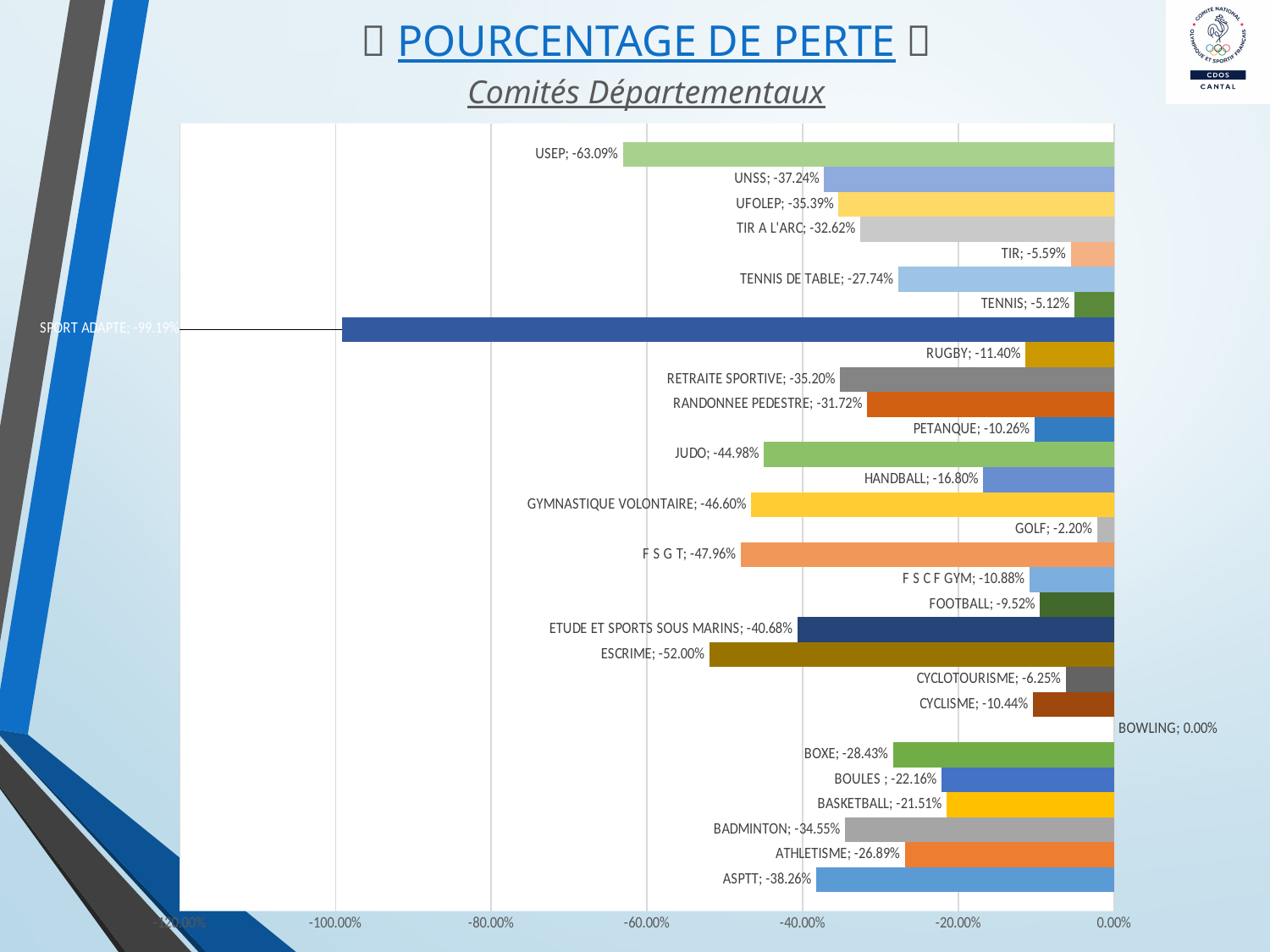
Which category has the highest value (smallest percentage loss)? BOWLING What type of chart is shown on the slide? Bar chart What is the title of the chart on the slide? POURCENTAGE DE PERTE How many categories are plotted in the chart? 30 What is the value shown for ESCRIME? -52.00% What is the value shown for JUDO? -44.98% What is the difference between the values for USEP and UNSS? 25.85 percentage points What is the value shown for BOWLING? 0.00% Which has a larger percentage loss, FOOTBALL or RUGBY? RUGBY What is the value shown for TENNIS DE TABLE? -27.74% Which has a larger percentage loss, GYMNASTIQUE VOLONTAIRE or HANDBALL? GYMNASTIQUE VOLONTAIRE Which category has the lowest value (largest percentage loss)? SPORT ADAPTE